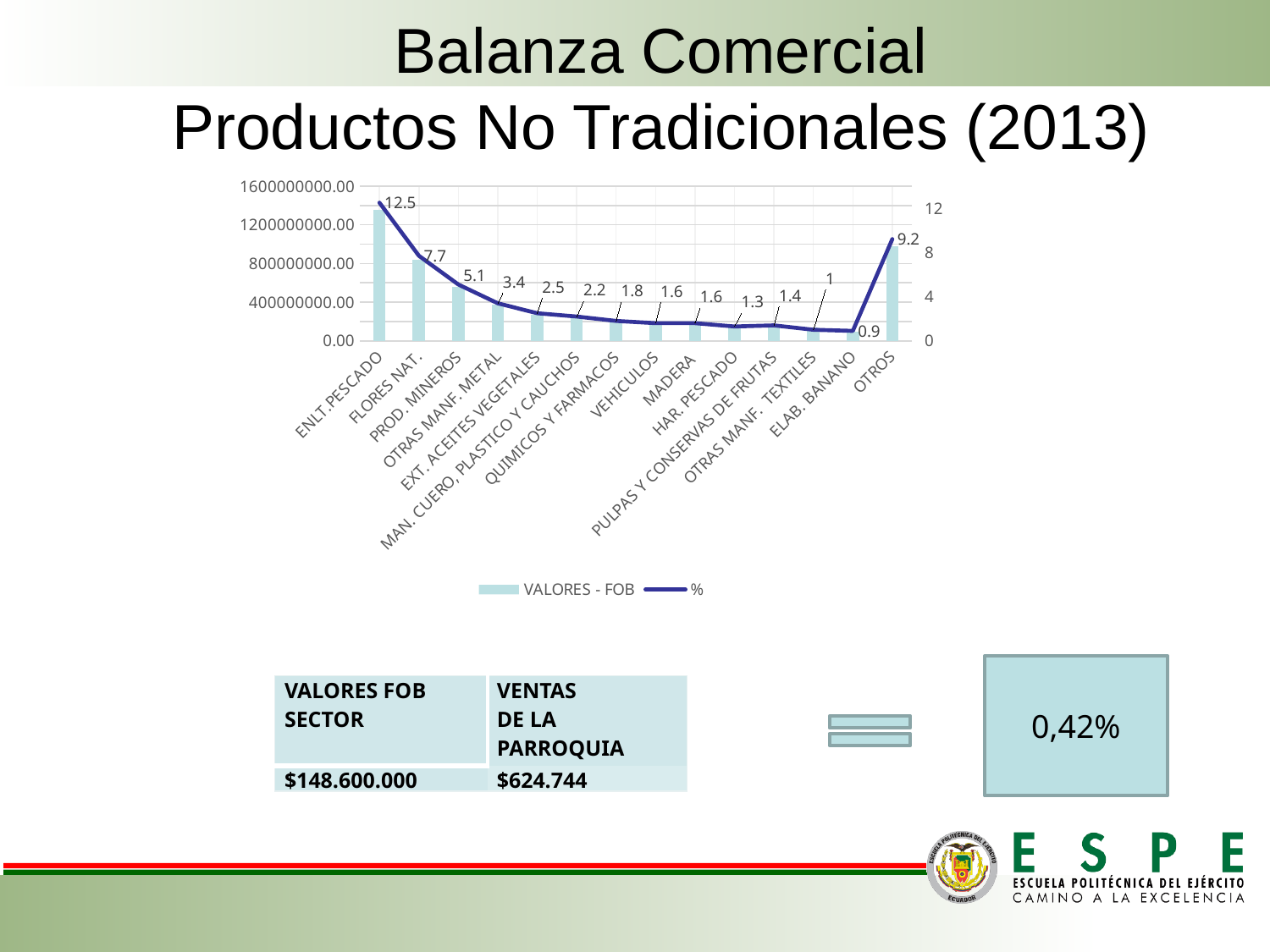
Which category has the highest % value? ENLT. PESCADO What is the % value for ELAB. BANANO? 0.9 How many categories are shown on the x axis of the chart? 14 What is the % value for ENLT. PESCADO? 12.5 How many series does the legend list? 2 What is the % value for PROD. MINEROS? 5.1 Is the VALORES - FOB bar for OTROS greater or less than 1200000000.00? less Which category has the lowest % value? ELAB. BANANO Is the VALORES - FOB bar for ENLT. PESCADO greater or less than 1200000000.00? greater Which has a larger % value, FLORES NAT. or PROD. MINEROS? FLORES NAT. What is the % value for OTROS? 9.2 What is the difference between the % values for ENLT. PESCADO and OTROS? 3.3